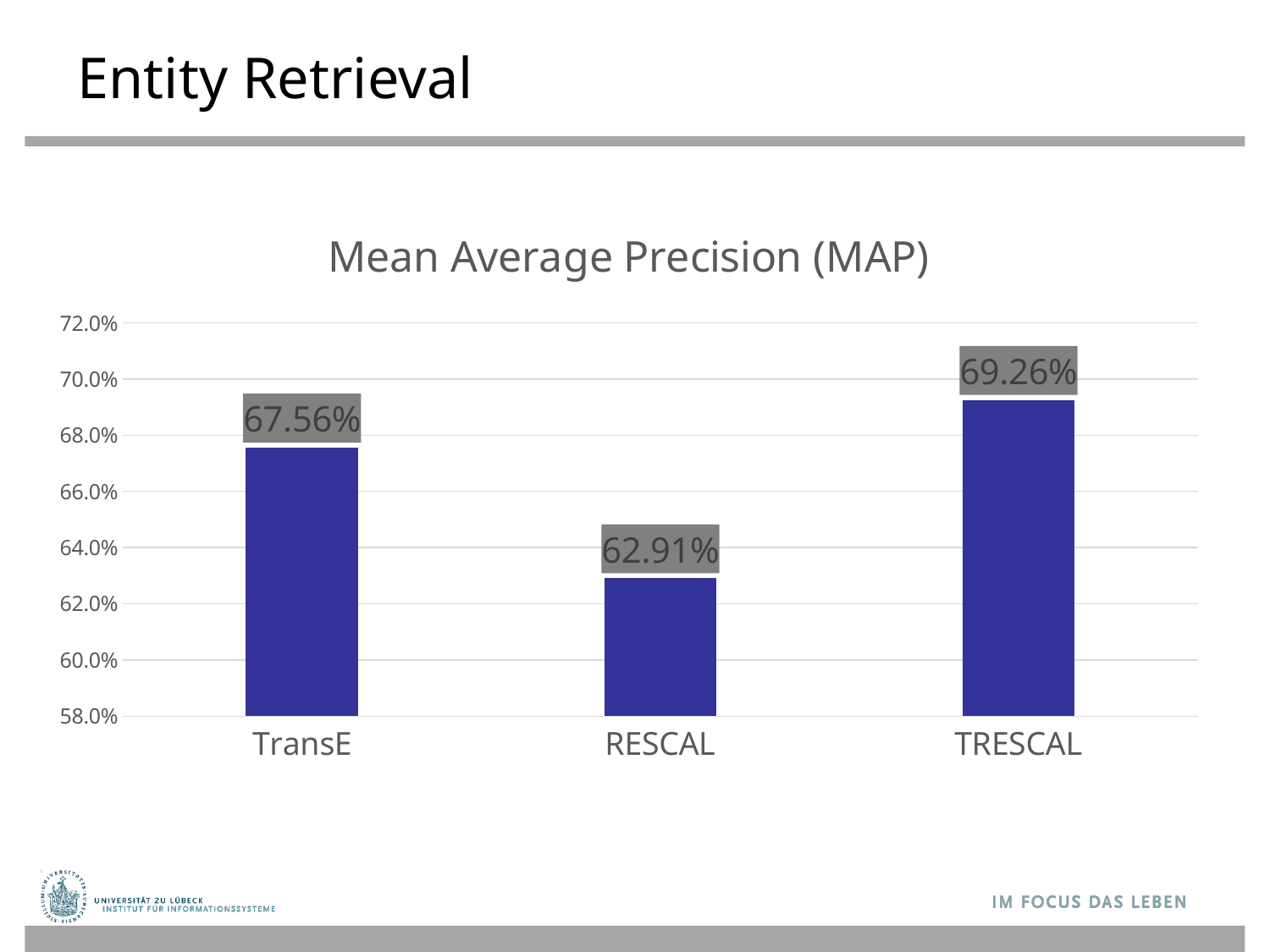
How many methods are compared in the chart? 3 What is the MAP value for TRESCAL? 69.26% What is the title of the chart? Mean Average Precision (MAP) What is the difference in MAP between TRESCAL and RESCAL? 6.35% What is the difference in MAP between TRESCAL and TransE? 1.70% Which method has the highest Mean Average Precision? TRESCAL Is the MAP value for RESCAL greater or less than 64.0%? less What is the MAP value for RESCAL? 62.91% Which method has the lowest Mean Average Precision? RESCAL Which has a higher MAP, TransE or RESCAL? TransE What kind of chart is shown on the slide? bar chart What is the MAP value for TransE? 67.56%